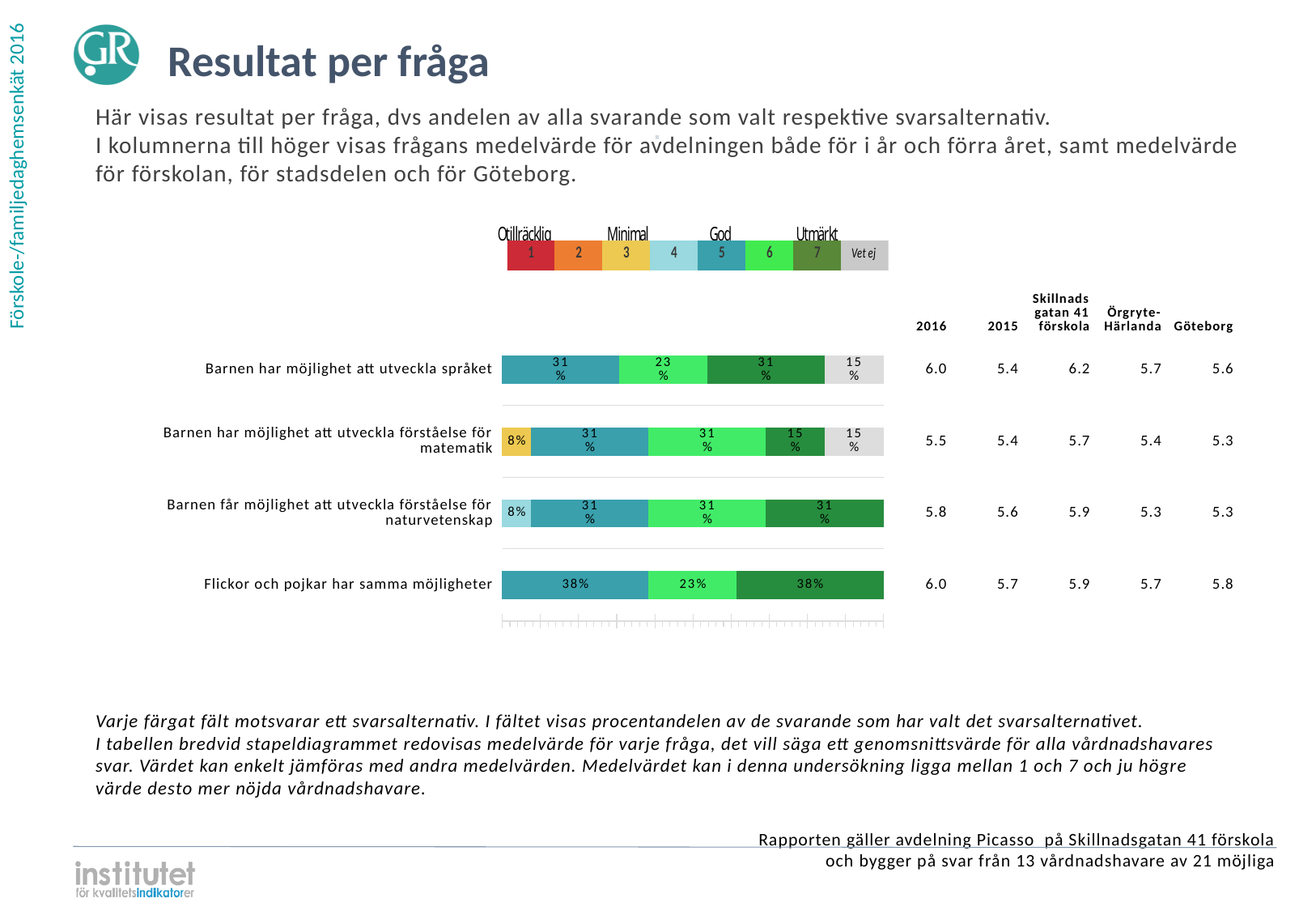
Which is larger for 'Barnen har möjlighet att utveckla språket': the 2016 mean or the 2015 mean? 2016 mean What kind of chart is used to show the distribution of answers per question? Stacked bar chart How many questions (categories) are shown in the bar chart? 4 What is the 2016 mean value for 'Barnen har möjlighet att utveckla förståelse för matematik'? 5.5 How many answer alternatives does the colour legend above the chart list? 8 What percentage of respondents chose 'Vet ej' for 'Barnen har möjlighet att utveckla språket'? 15% What percentage chose answer alternative 7 (dark green) for 'Barnen får möjlighet att utveckla förståelse för naturvetenskap'? 31% What percentage chose answer alternative 7 (dark green) for 'Flickor och pojkar har samma möjligheter'? 38% For 'Flickor och pojkar har samma möjligheter', what is the difference between the share choosing alternative 5 (38%) and the share choosing alternative 6 (23%)? 15 percentage points What is the Göteborg mean value for 'Flickor och pojkar har samma möjligheter'? 5.8 What percentage chose answer alternative 3 (yellow) for 'Barnen har möjlighet att utveckla förståelse för matematik'? 8% Which question has the lowest 2016 mean value in the table? Barnen har möjlighet att utveckla förståelse för matematik